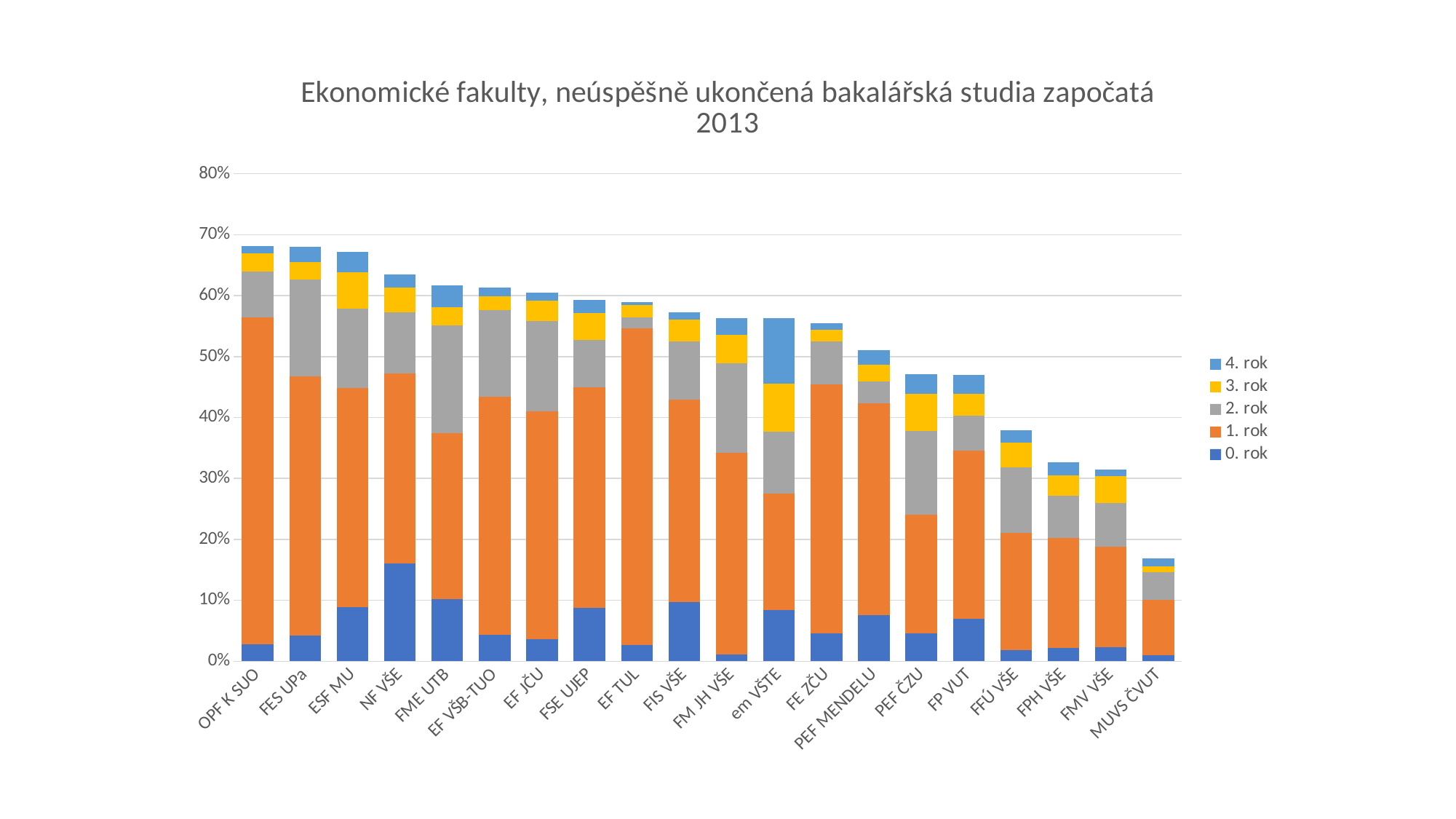
Is the total stacked value for FP VUT greater or less than 50%? less Is the total stacked value for MUVS ČVUT greater or less than 20%? less Which has the larger '0. rok' segment, NF VŠE or FME UTB? NF VŠE What kind of chart is shown on the slide? stacked bar chart Is the total stacked value for OPF K SUO greater or less than 60%? greater Which faculty has the largest '4. rok' segment? em VŠTE How many faculties (categories) are shown on the x axis? 20 Which faculty has the largest '0. rok' segment? NF VŠE Do the total stacked values generally rise or fall from left to right along the x axis? fall How many series does the legend list? 5 Which faculty has the lowest total stacked bar? MUVS ČVUT